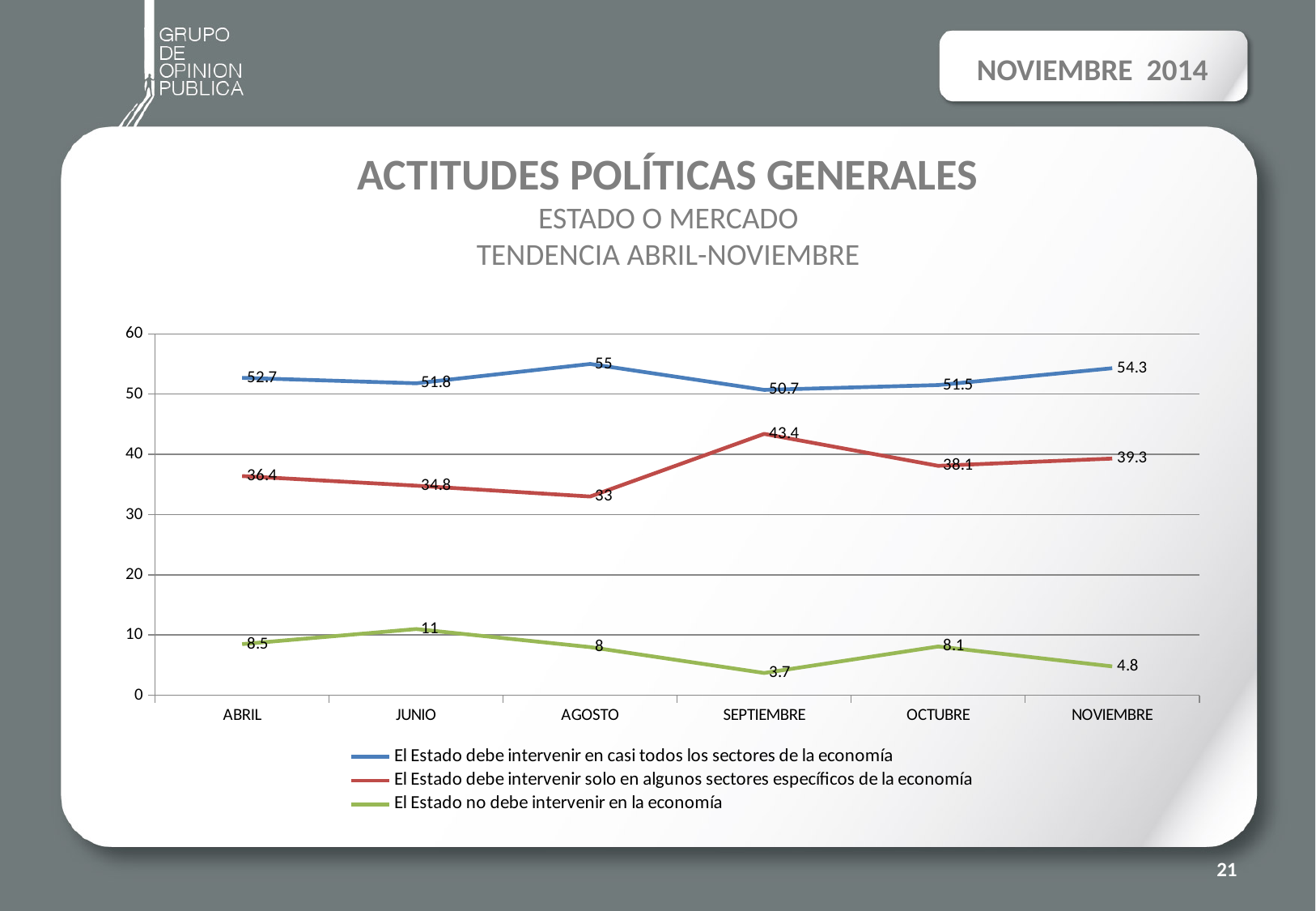
How many months are shown on the x axis? 6 What is the value for 'El Estado debe intervenir en casi todos los sectores de la economía' in NOVIEMBRE? 54.3 What is the difference between the values for 'El Estado debe intervenir solo en algunos sectores específicos de la economía' in SEPTIEMBRE and AGOSTO? 10.4 What is the value for 'El Estado debe intervenir solo en algunos sectores específicos de la economía' in SEPTIEMBRE? 43.4 What colour is the line for 'El Estado no debe intervenir en la economía'? green What is the value for 'El Estado no debe intervenir en la economía' in JUNIO? 11 In which month is 'El Estado debe intervenir en casi todos los sectores de la economía' highest? AGOSTO What kind of chart is shown on the slide? line chart Which is larger in OCTUBRE: 'El Estado debe intervenir en casi todos los sectores de la economía' or 'El Estado debe intervenir solo en algunos sectores específicos de la economía'? El Estado debe intervenir en casi todos los sectores de la economía In which month is 'El Estado no debe intervenir en la economía' lowest? SEPTIEMBRE Does the value for 'El Estado debe intervenir solo en algunos sectores específicos de la economía' rise or fall from ABRIL to AGOSTO? fall How many series does the legend list? 3